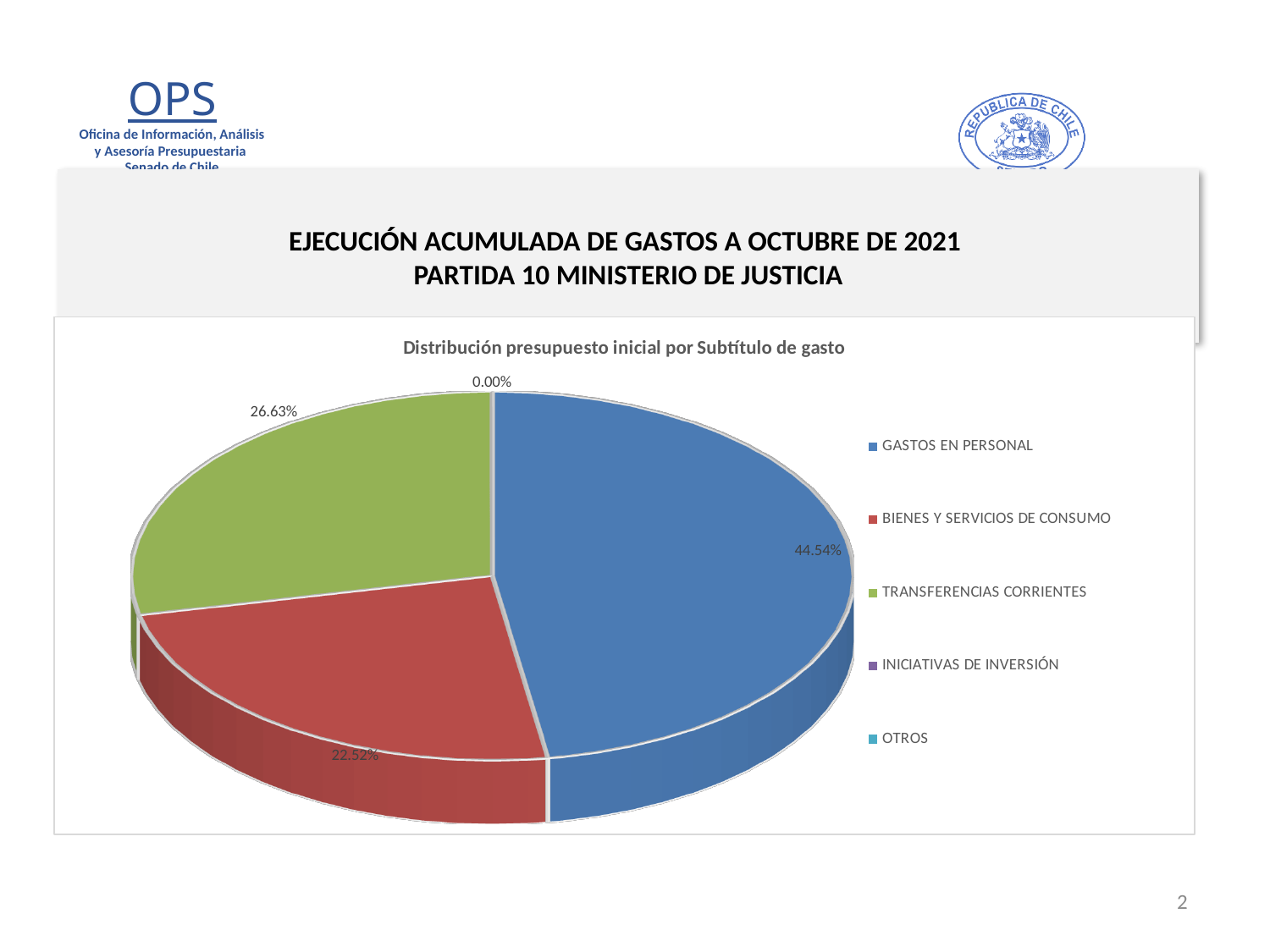
By how many percentage points does GASTOS EN PERSONAL exceed BIENES Y SERVICIOS DE CONSUMO in the pie chart? 22.02 percentage points What kind of chart is shown on the slide? Pie chart What percentage does the pie chart show for TRANSFERENCIAS CORRIENTES? 26.63% Which category has the largest slice of the pie chart? GASTOS EN PERSONAL Which is larger in the pie chart, GASTOS EN PERSONAL or TRANSFERENCIAS CORRIENTES? GASTOS EN PERSONAL Which is larger in the pie chart, TRANSFERENCIAS CORRIENTES or BIENES Y SERVICIOS DE CONSUMO? TRANSFERENCIAS CORRIENTES What percentage does the pie chart show for GASTOS EN PERSONAL? 44.54% By how many percentage points does TRANSFERENCIAS CORRIENTES exceed BIENES Y SERVICIOS DE CONSUMO in the pie chart? 4.11 percentage points How many entries does the legend of the pie chart list? 5 What colour represents GASTOS EN PERSONAL in the pie chart? Blue What percentage does the pie chart show for BIENES Y SERVICIOS DE CONSUMO? 22.52% What is the title of the chart on the slide? Distribución presupuesto inicial por Subtítulo de gasto